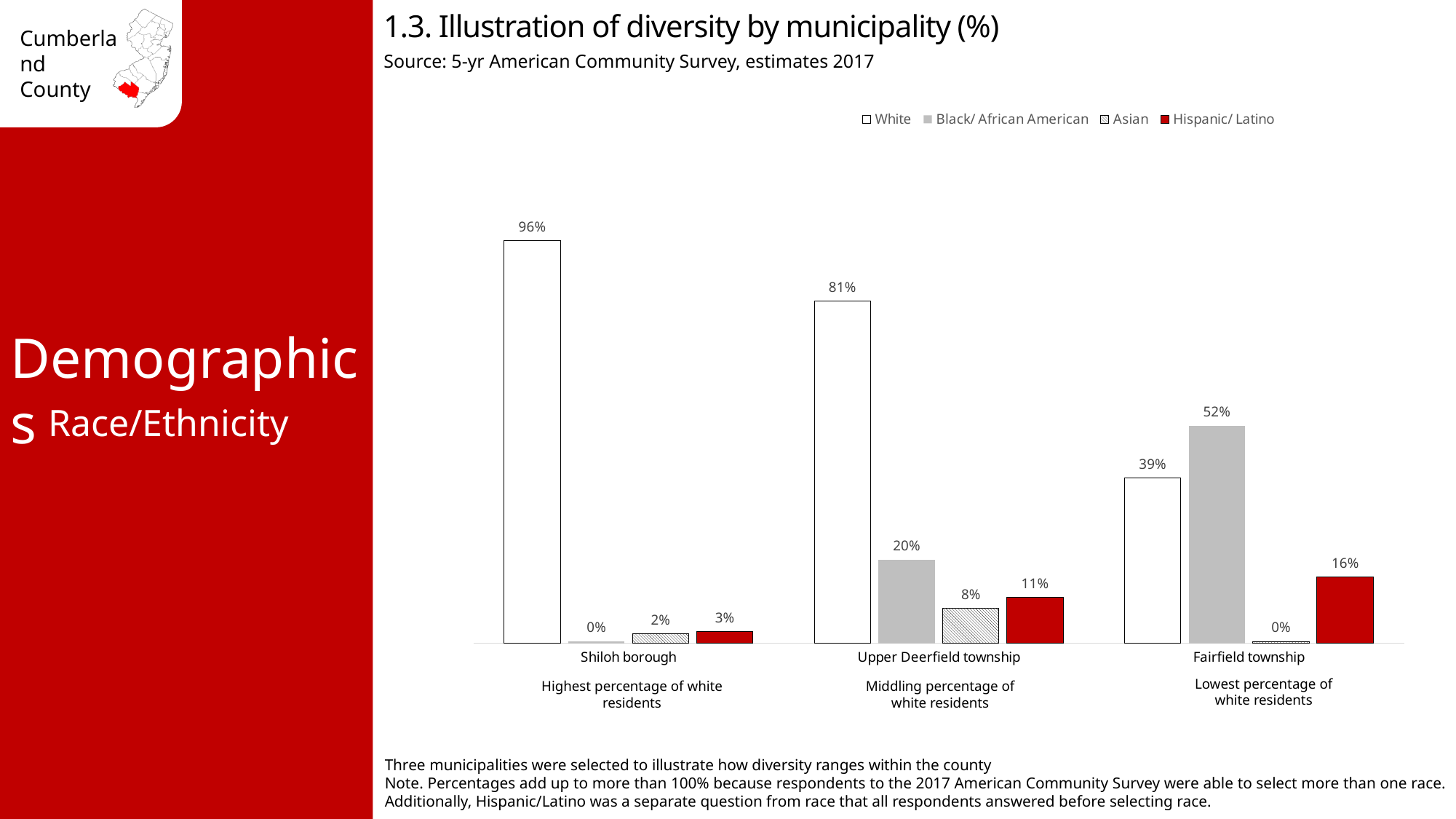
What percentage of Shiloh borough residents are White? 96% Which municipality has the lowest Hispanic/ Latino percentage? Shiloh borough What is the difference between the White percentage in Shiloh borough and in Fairfield township? 57% How many municipalities are shown on the chart? 3 What kind of chart is shown on the slide? Bar chart What is the Asian percentage for Upper Deerfield township? 8% What is the Black/ African American percentage for Fairfield township? 52% In Fairfield township, which is larger: the White percentage or the Black/ African American percentage? Black/ African American How many series does the legend list? 4 Which municipality has the highest White percentage? Shiloh borough What is the Hispanic/ Latino percentage for Upper Deerfield township? 11% Which series is shown in red on the chart? Hispanic/ Latino